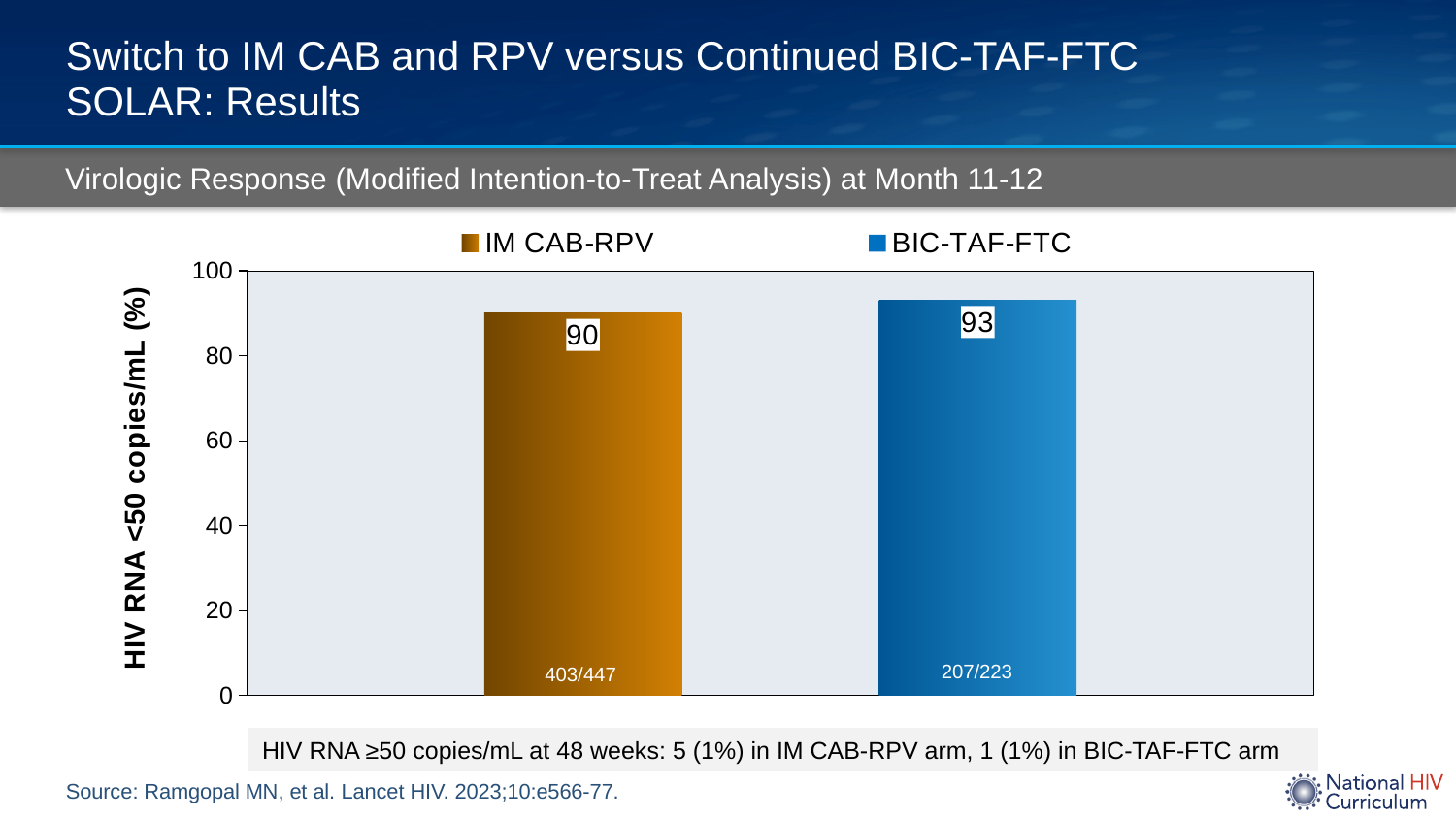
Which arm has the higher virologic response? BIC-TAF-FTC What kind of chart is shown? bar chart Which arm has the lower virologic response? IM CAB-RPV What fraction is printed at the base of the BIC-TAF-FTC bar? 207/223 How many series does the legend list? 2 What is the difference between the BIC-TAF-FTC and IM CAB-RPV values? 3 What fraction is printed at the base of the IM CAB-RPV bar? 403/447 What is the y-axis label of the chart? HIV RNA <50 copies/mL (%) What is the value for BIC-TAF-FTC? 93 Is the value for IM CAB-RPV greater or less than 80? greater What is the value for IM CAB-RPV? 90 How many bars are plotted in the chart? 2